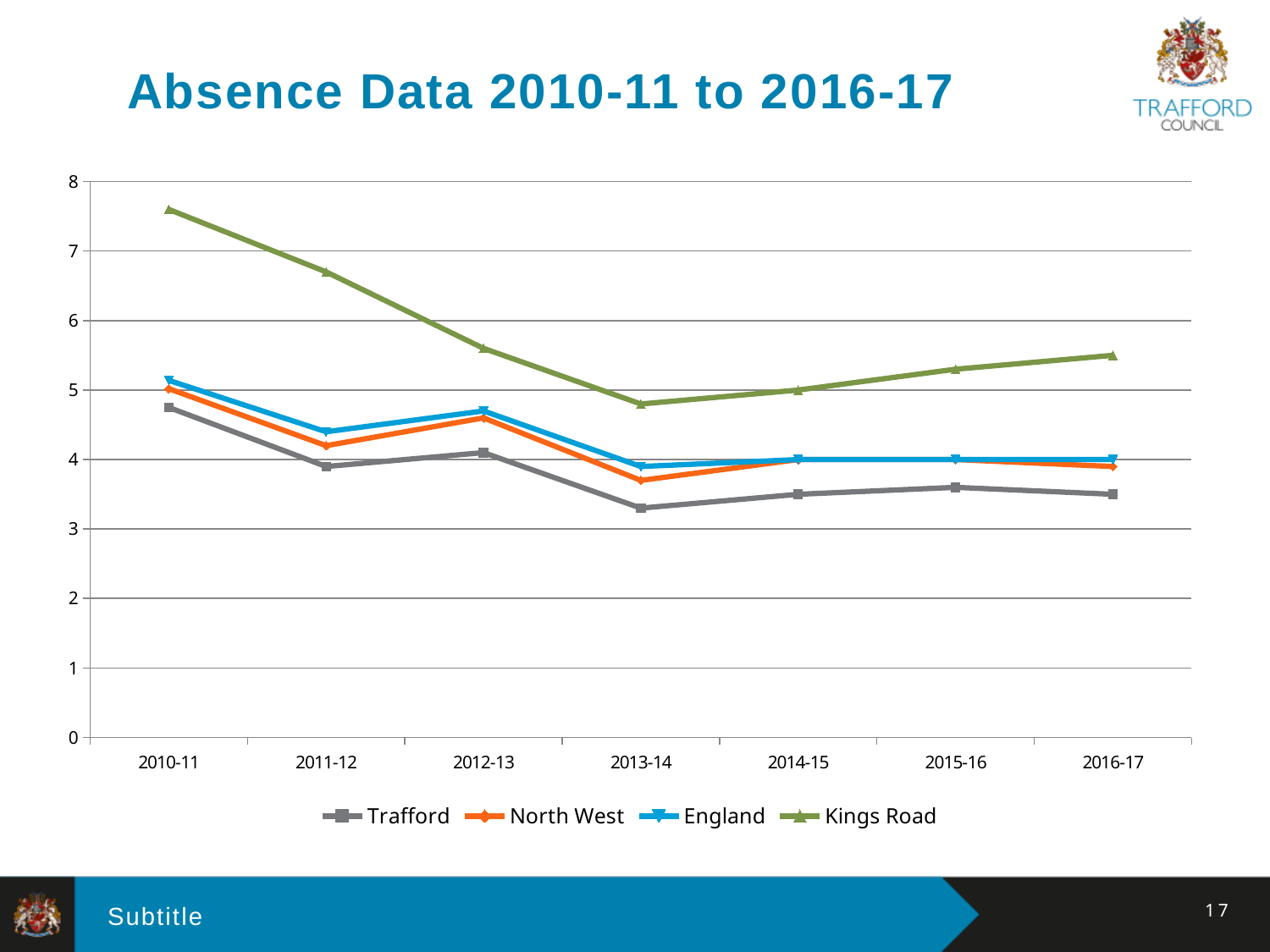
Which is larger in 2016-17, the value for Kings Road or the value for Trafford? Kings Road What is the title of the chart? Absence Data 2010-11 to 2016-17 How many series does the legend list? 4 Which series has the lowest value in 2016-17? Trafford How many academic years are plotted along the x axis? 7 In which year does the Kings Road series reach its highest value? 2010-11 Which series has the highest value in 2010-11? Kings Road Is the value for Trafford in 2013-14 greater or less than 4? less In which year does the Kings Road series reach its lowest value? 2013-14 What kind of chart is shown on the slide? line chart Does the Kings Road series rise or fall from 2010-11 to 2013-14? fall Is the value for Kings Road in 2010-11 greater or less than 7? greater